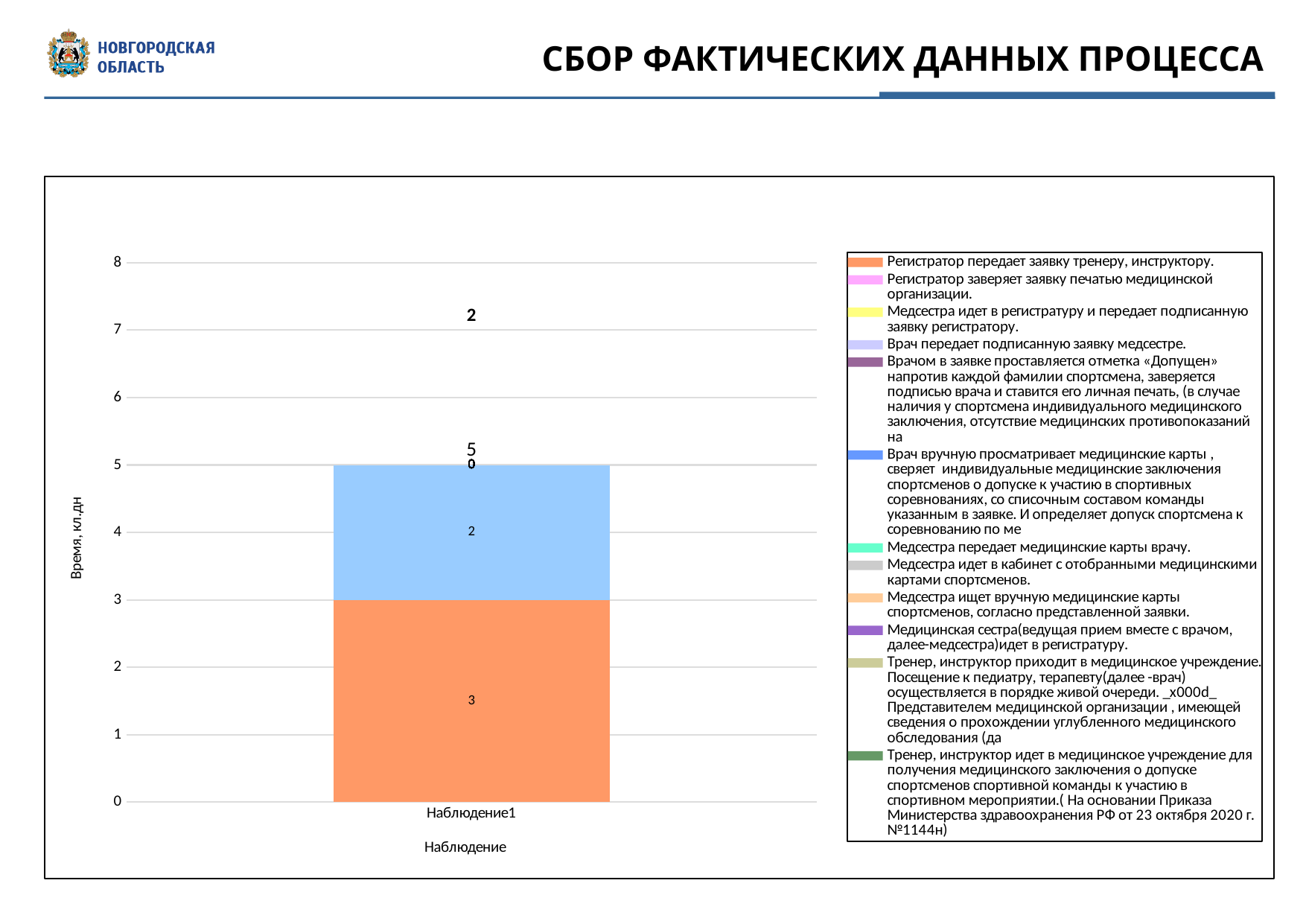
Which segment of the bar for Наблюдение1 is larger, the orange one or the light blue one? The orange one What is the value of the orange (bottom) segment of the bar for Наблюдение1? 3 What is the total height of the stacked bar for Наблюдение1? 5 How many series does the chart's legend list? 12 What is the label of the single category on the x axis? Наблюдение1 What is the value of the light blue (upper) segment of the bar for Наблюдение1? 2 What kind of chart is shown on the slide? Stacked bar chart What is the difference between the orange segment and the light blue segment of the bar for Наблюдение1? 1 Is the top of the stacked bar for Наблюдение1 greater or less than 6? less How many categories are plotted on the x axis of the chart? 1 What is the title of the y axis of the chart? Время, кл.дн